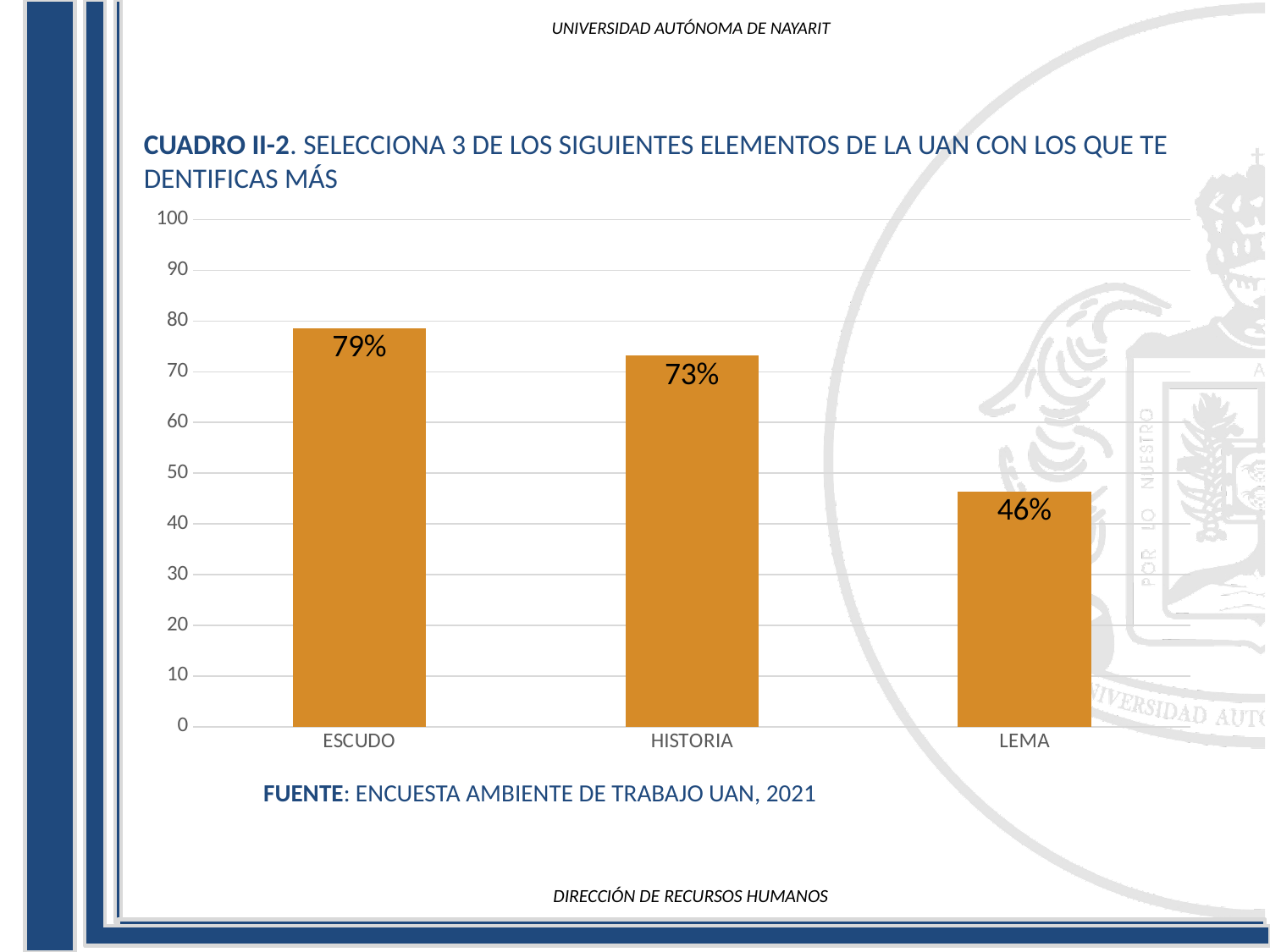
What source is cited below the chart? ENCUESTA AMBIENTE DE TRABAJO UAN, 2021 What is the value for HISTORIA? 73% What is the difference between the values for ESCUDO and HISTORIA? 6% How many categories are shown on the x axis? 3 What is the value for ESCUDO? 79% Which is larger, the value for HISTORIA or the value for LEMA? HISTORIA Is the value for LEMA greater or less than 50? less Which category has the highest value? ESCUDO Which category has the lowest value? LEMA What kind of chart is shown on the slide? bar chart What is the difference between the values for ESCUDO and LEMA? 33% What is the value for LEMA? 46%